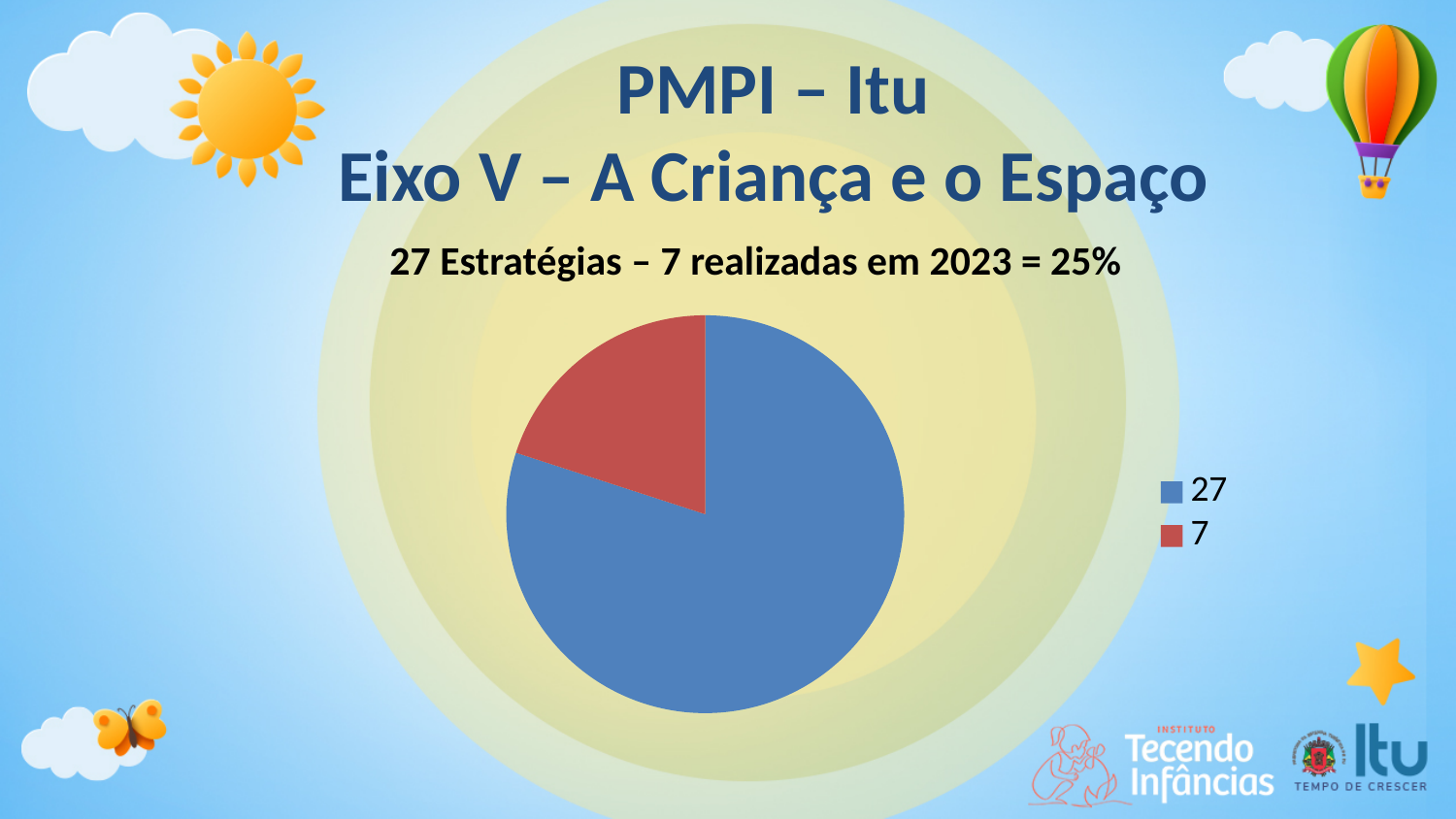
How many slices does the pie chart have? 2 Which legend category has the largest slice of the pie chart? 27 Which legend category has the smallest slice of the pie chart? 7 What colour is the slice labelled 27 in the pie chart? blue What kind of chart is shown on the slide? pie chart How many entries does the legend of the pie chart list? 2 What colour is the slice labelled 7 in the pie chart? red Which slice is smaller in the pie chart, the blue one or the red one? the red one Which slice is larger in the pie chart, the one labelled 27 or the one labelled 7? 27